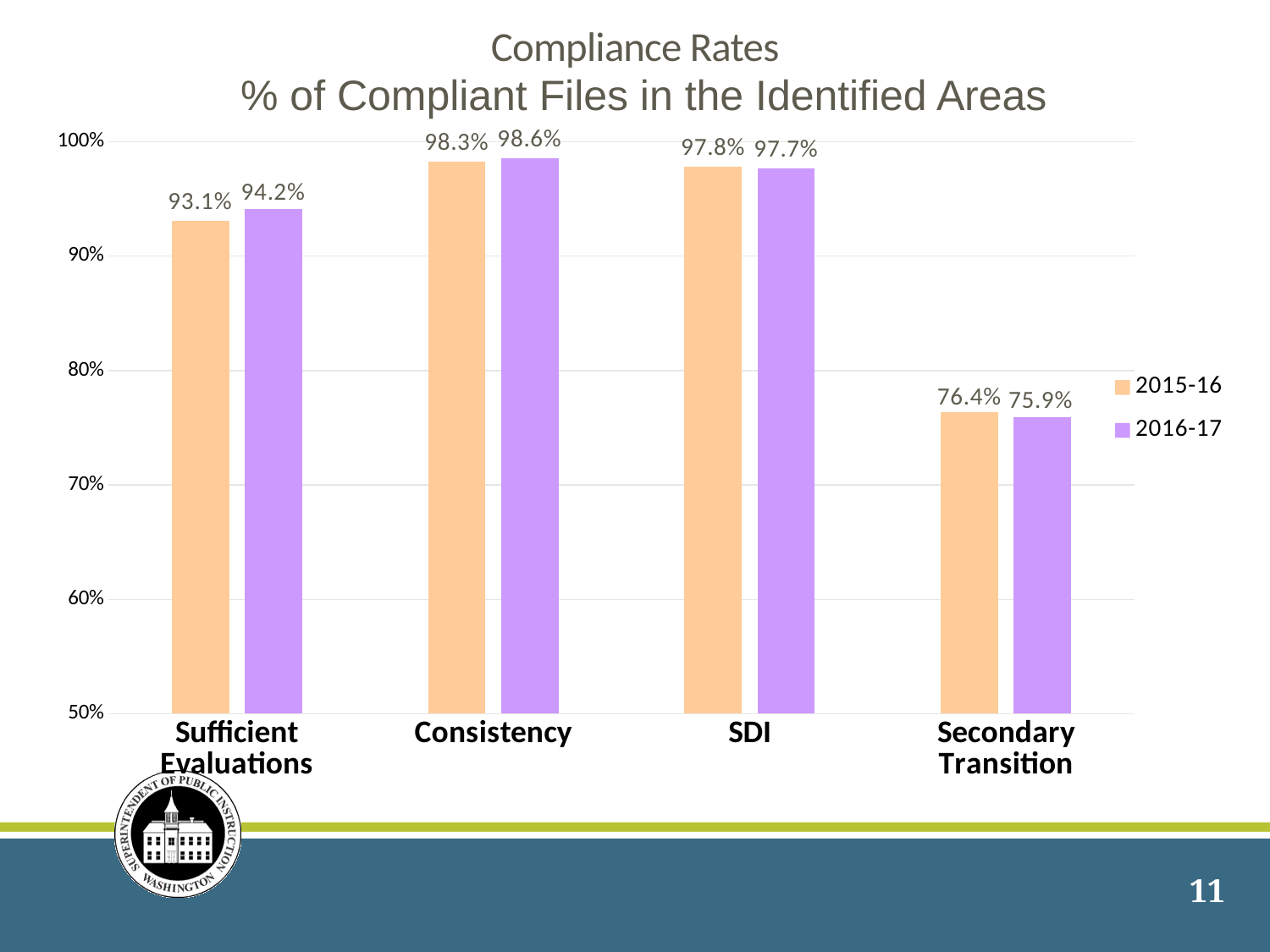
What is the 2015-16 compliance rate for Sufficient Evaluations? 93.1% For SDI, which year has the larger compliance rate, 2015-16 or 2016-17? 2015-16 What is the 2016-17 compliance rate for Secondary Transition? 75.9% How many areas are shown on the x axis? 4 How many series does the legend list? 2 What kind of chart is shown on the slide? bar chart Which area has the highest 2016-17 compliance rate? Consistency What is the difference between the 2016-17 and 2015-16 values for Sufficient Evaluations? 1.1% What is the 2016-17 value for Consistency? 98.6% Which colour represents the 2016-17 series? purple Is the 2015-16 value for Secondary Transition greater or less than 80%? less Which area has the lowest 2015-16 compliance rate? Secondary Transition